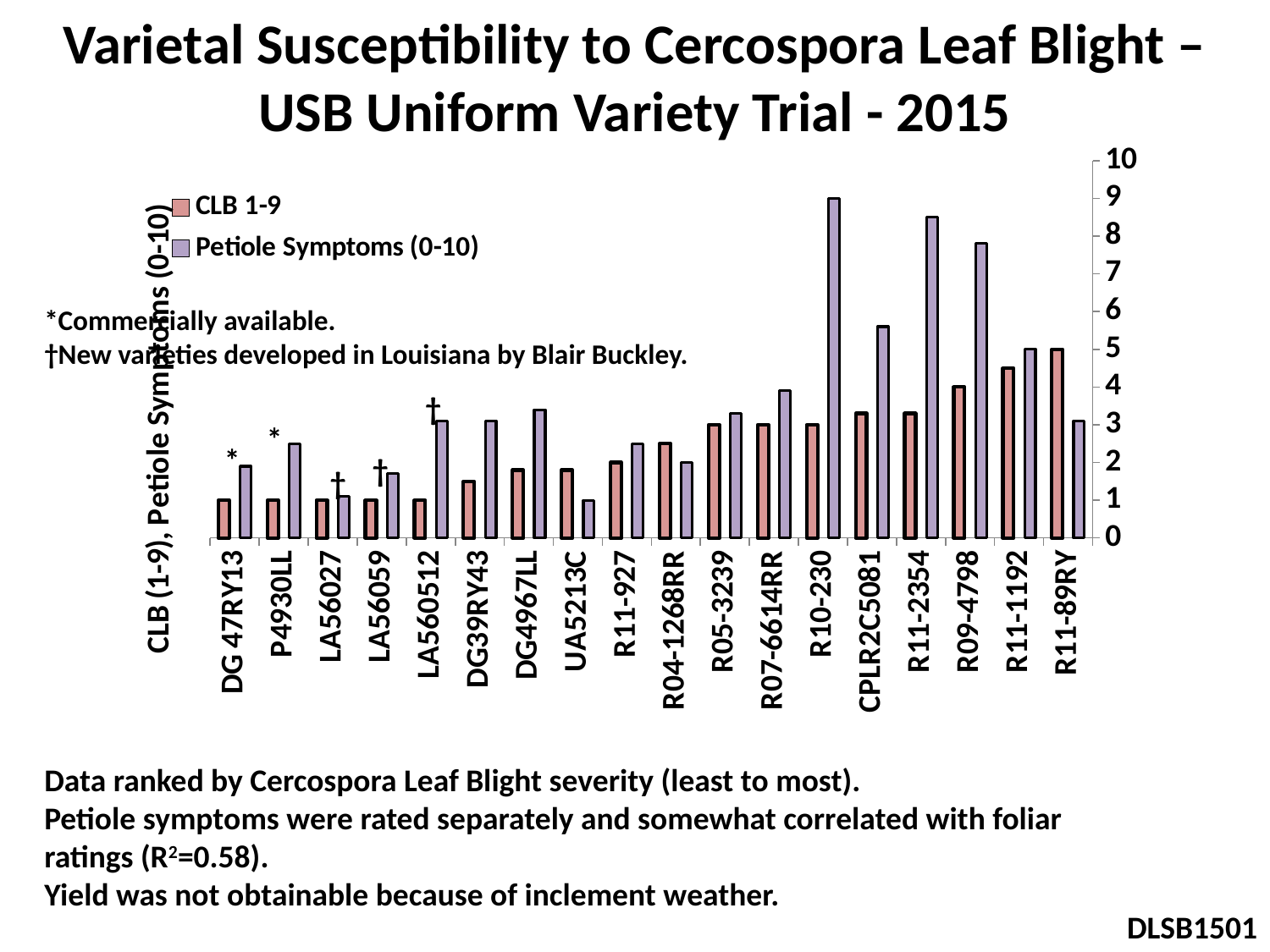
What are the two legend entries of the chart? CLB 1-9 and Petiole Symptoms (0-10) How many series does the legend list? 2 Which has the larger Petiole Symptoms (0-10) value, R10-230 or CPLR2C5081? R10-230 Which variety has the highest Petiole Symptoms (0-10) value? R10-230 Is the CLB 1-9 value for DG39RY43 greater or less than 2? less What kind of chart is shown on the slide? bar chart Do the CLB 1-9 values generally rise or fall moving left to right along the x axis? rise How many varieties are shown along the x axis? 18 Is the Petiole Symptoms (0-10) value for CPLR2C5081 greater or less than 5? greater Which variety has the highest CLB 1-9 value? R11-89RY Is the Petiole Symptoms (0-10) value for R11-2354 greater or less than 8? greater